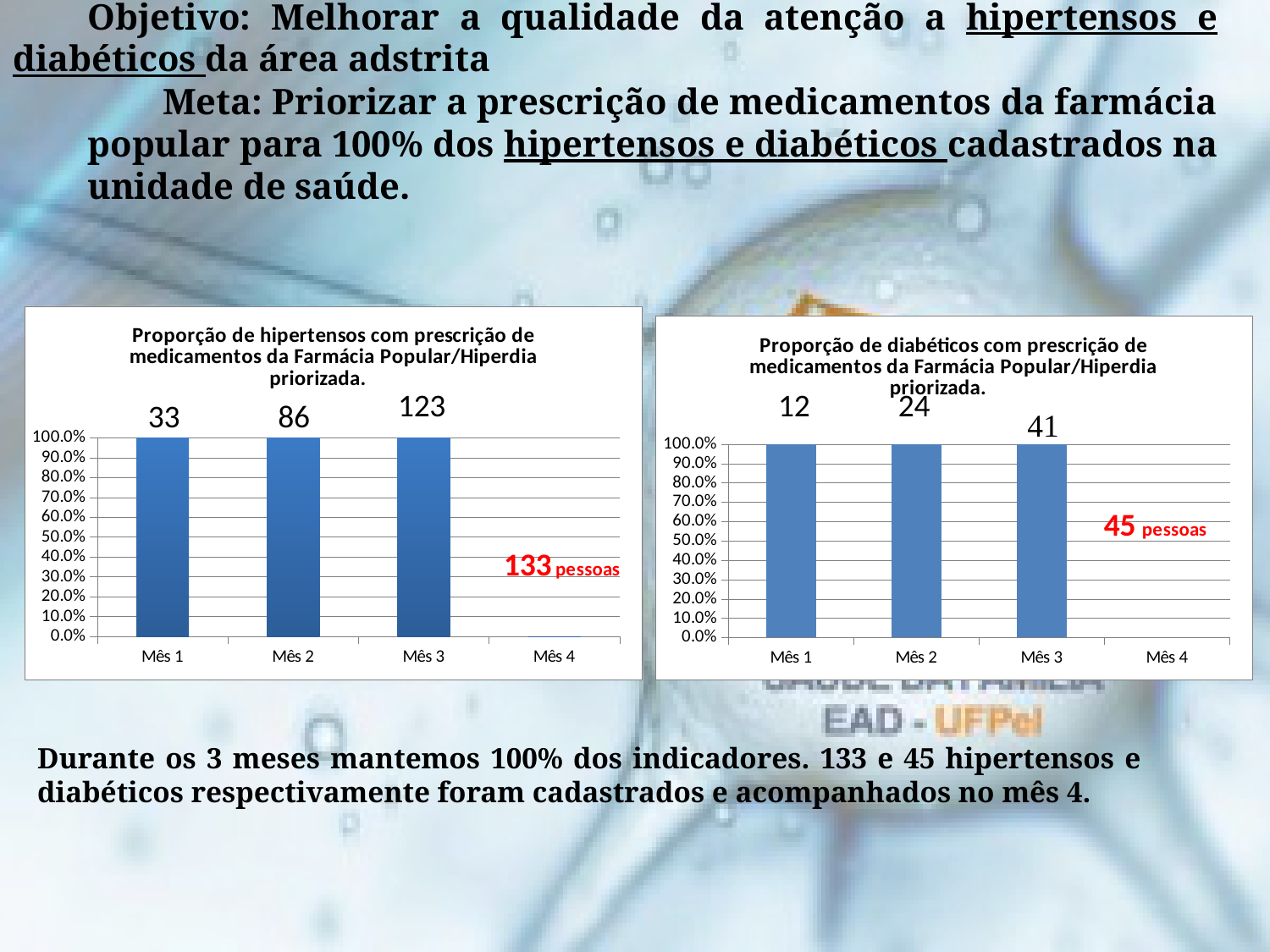
In the right chart (Proporção de diabéticos), what data label is shown above the bar for Mês 2? 24 In the right chart (Proporção de diabéticos), is the data label for Mês 3 larger than the data label for Mês 2? Yes How many months are shown on the x axis of the left chart (Proporção de hipertensos)? 4 In the right chart (Proporção de diabéticos), what percentage does the bar for Mês 1 reach on the y axis? 100.0% In the right chart (Proporção de diabéticos), what data label is shown above the bar for Mês 3? 41 In the left chart (Proporção de hipertensos), what is the difference between the data labels for Mês 3 and Mês 1? 90 In the left chart (Proporção de hipertensos), which month has the largest data label? Mês 3 In the left chart (Proporção de hipertensos), what data label is shown above the bar for Mês 1? 33 In the right chart (Proporção de diabéticos), which month has the smallest data label? Mês 1 In the left chart (Proporção de hipertensos), what percentage does the bar for Mês 2 reach on the y axis? 100.0% What kind of chart is the right chart (Proporção de diabéticos)? Bar chart In the left chart (Proporção de hipertensos), what data label is shown above the bar for Mês 3? 123